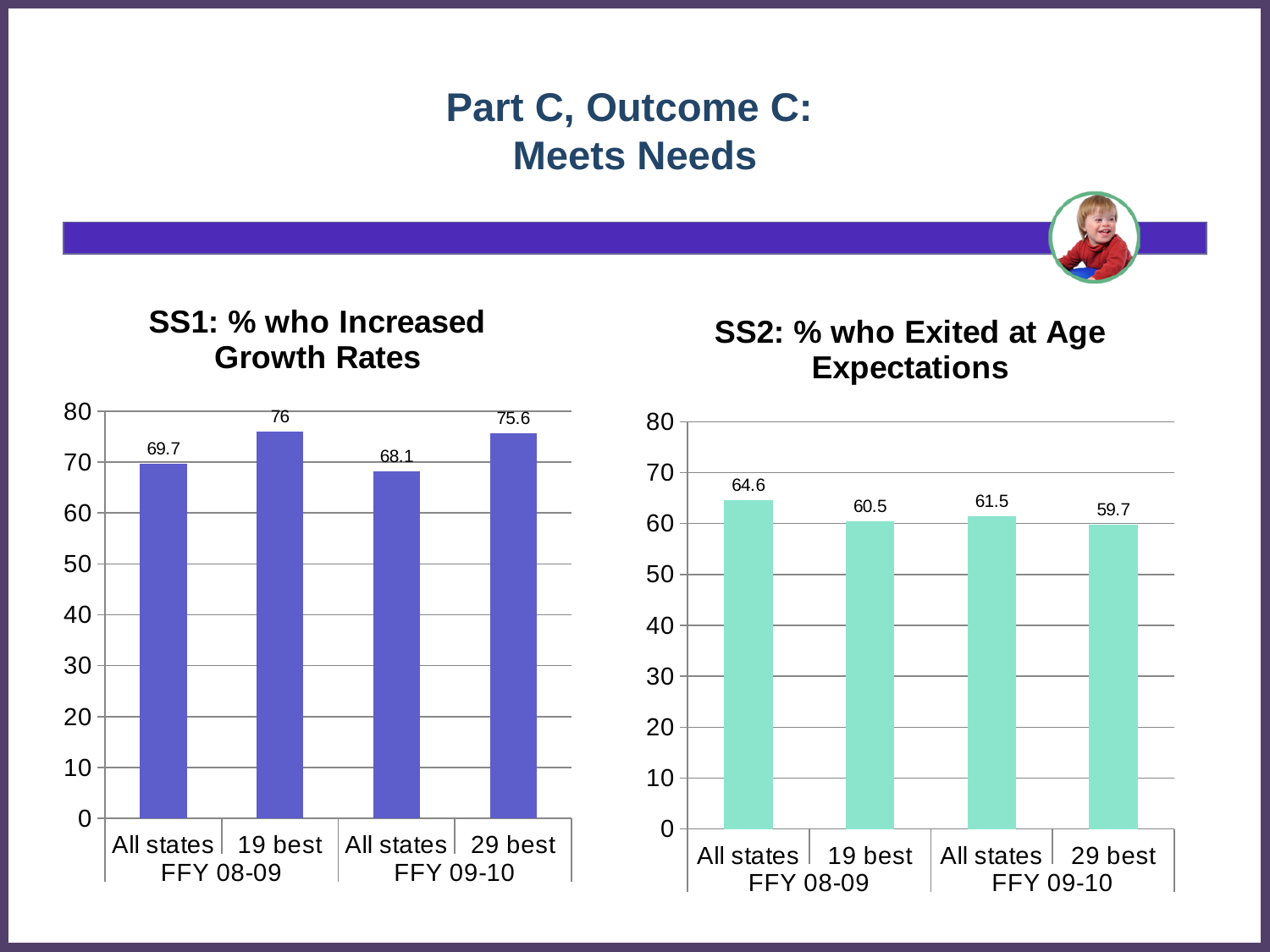
In the SS2: % who Exited at Age Expectations chart, what is the difference between the All states value in FFY 08-09 and the All states value in FFY 09-10? 3.1 In the SS2: % who Exited at Age Expectations chart, which bar has the lowest value? 29 best, FFY 09-10 What kind of chart is the SS2: % who Exited at Age Expectations chart? Bar chart In the SS1: % who Increased Growth Rates chart, is the value for All states in FFY 09-10 greater or less than 70? less How many bars are plotted in the SS1: % who Increased Growth Rates chart? 4 In the SS1: % who Increased Growth Rates chart, what is the difference between the 19 best value in FFY 08-09 and the All states value in FFY 08-09? 6.3 In the SS2: % who Exited at Age Expectations chart, what is the value for All states in FFY 09-10? 61.5 In the SS2: % who Exited at Age Expectations chart, what is the value for 19 best in FFY 08-09? 60.5 In the SS1: % who Increased Growth Rates chart, what is the value for 29 best in FFY 09-10? 75.6 In the SS1: % who Increased Growth Rates chart, what is the value for All states in FFY 08-09? 69.7 In the SS2: % who Exited at Age Expectations chart, which is larger: All states in FFY 08-09 or 19 best in FFY 08-09? All states in FFY 08-09 In the SS1: % who Increased Growth Rates chart, which bar has the highest value? 19 best, FFY 08-09